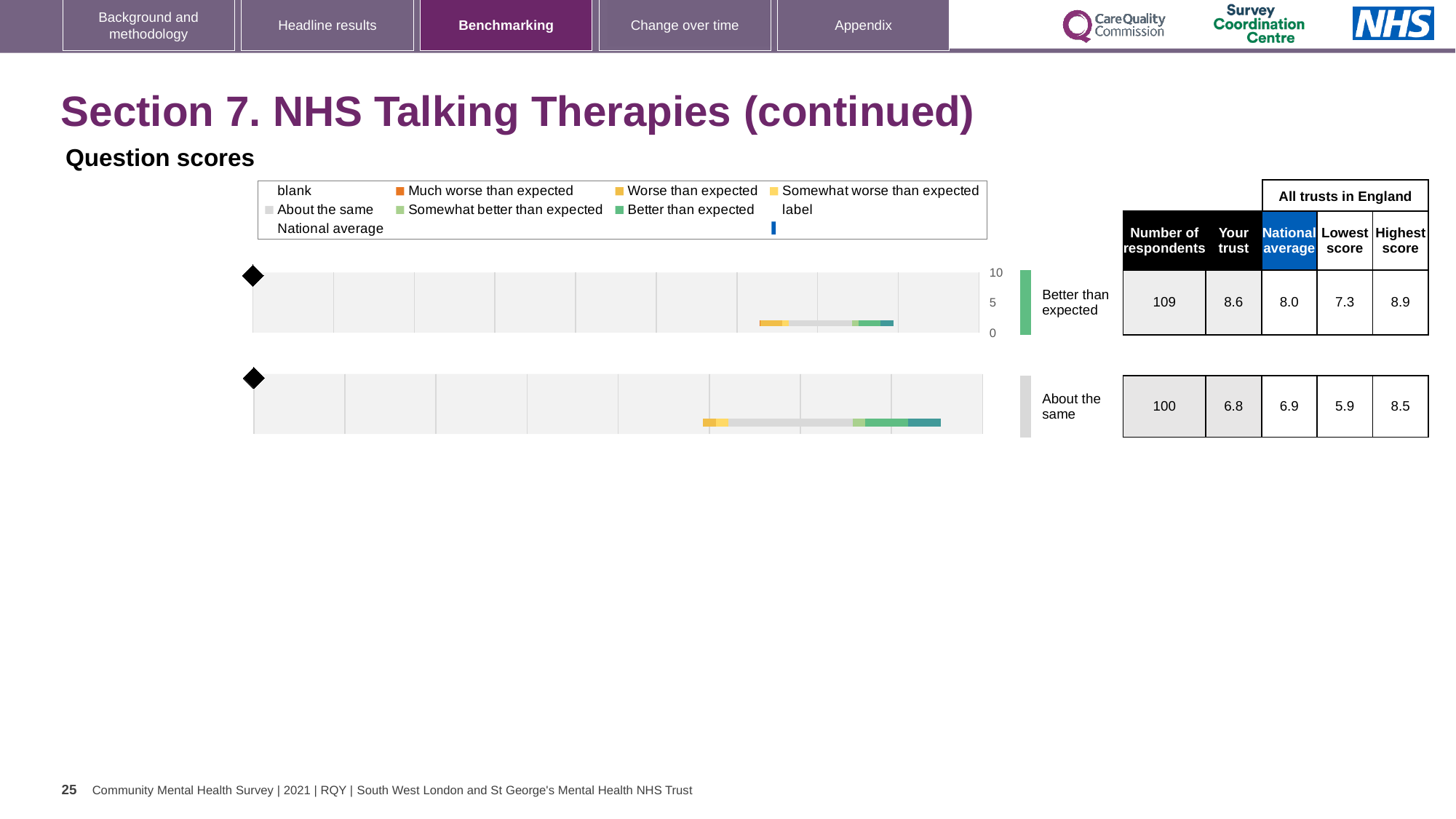
In the benchmarking table, what is the national average for the 'Better than expected' row? 8.0 In the benchmarking table, how many respondents are listed for the 'Better than expected' row? 109 In the benchmarking table, what is the 'Your trust' score for the 'Better than expected' row? 8.6 For the 'Better than expected' row, what is the difference between the 'Your trust' score and the national average? 0.6 How many benchmarking chart rows are shown on the slide? 2 In the benchmarking table, what is the lowest score for the 'Better than expected' row? 7.3 For the 'About the same' row, which is larger: the 'Your trust' score or the national average? National average In the benchmarking table, how many respondents are listed for the 'About the same' row? 100 For the 'About the same' row, what is the difference between the highest score and the lowest score? 2.6 What kind of chart is used for the benchmarking rows on the slide? Bar chart What is the highest tick value shown on the vertical axis next to the first benchmarking chart? 10 In the benchmarking table, what is the highest score for the 'About the same' row? 8.5